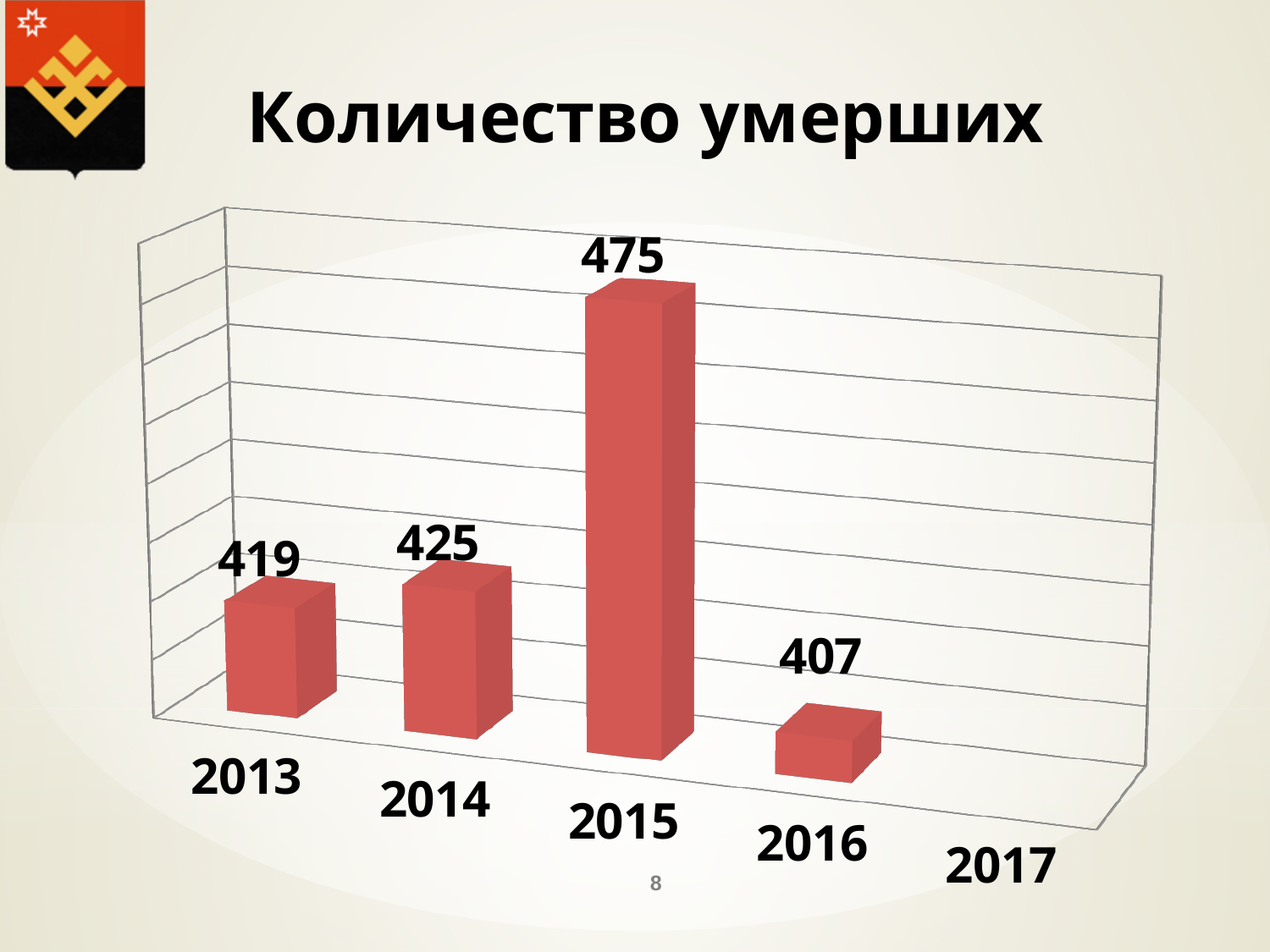
Which year has the highest value? 2015 How many years are labelled on the x axis? 5 Which is larger, the value for 2014 or the value for 2016? 2014 What is the value for 2016? 407 What is the difference between the values for 2015 and 2016? 68 Which year among those with a plotted bar has the lowest value? 2016 What is the title of the chart? Количество умерших What is the difference between the values for 2014 and 2013? 6 What is the value for 2015? 475 What is the value for 2014? 425 What is the value for 2013? 419 What kind of chart is shown? Bar chart